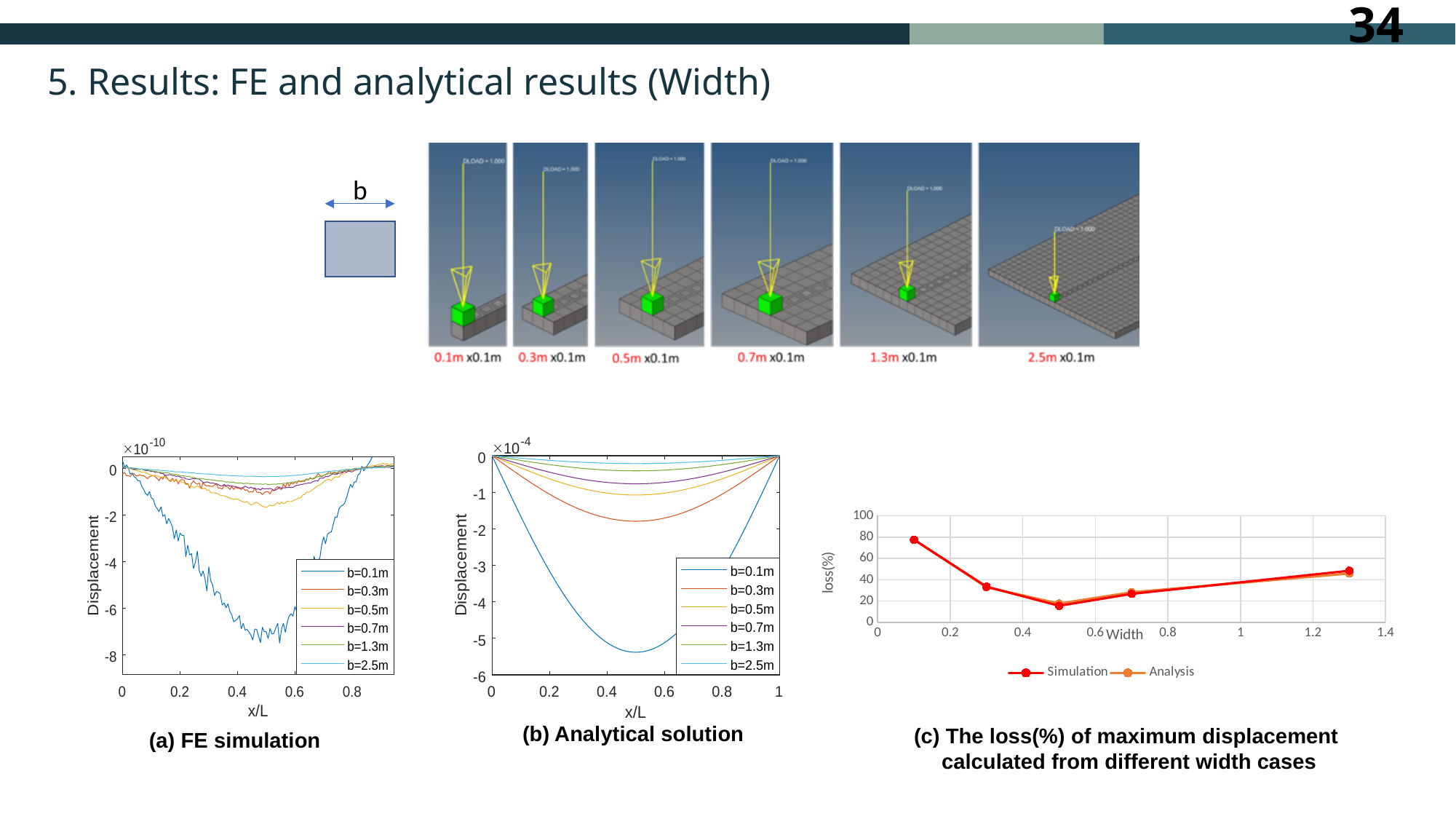
On chart (c), at which width is the Simulation loss(%) lowest? 0.5 On chart (c), how many series does the legend list? 2 On chart (c), is the Simulation loss(%) at width 1.3 greater or less than 40? greater On chart (c), at which width is the Simulation loss(%) highest? 0.1 On chart (b) Analytical solution, which series reaches the largest (most negative) displacement? b=0.1m On chart (c), how many data points are plotted for the Simulation series? 5 On chart (c), does the Simulation loss(%) rise or fall as width increases from 0.1 to 0.5? fall On chart (a) FE simulation, how many series does the legend list? 6 On chart (c), is the Simulation loss(%) at width 0.1 greater or less than 60? greater On chart (c), what are the two legend entries? Simulation and Analysis What kind of chart is chart (b) Analytical solution? line chart On chart (c), is the Simulation loss(%) at width 0.5 greater or less than 40? less